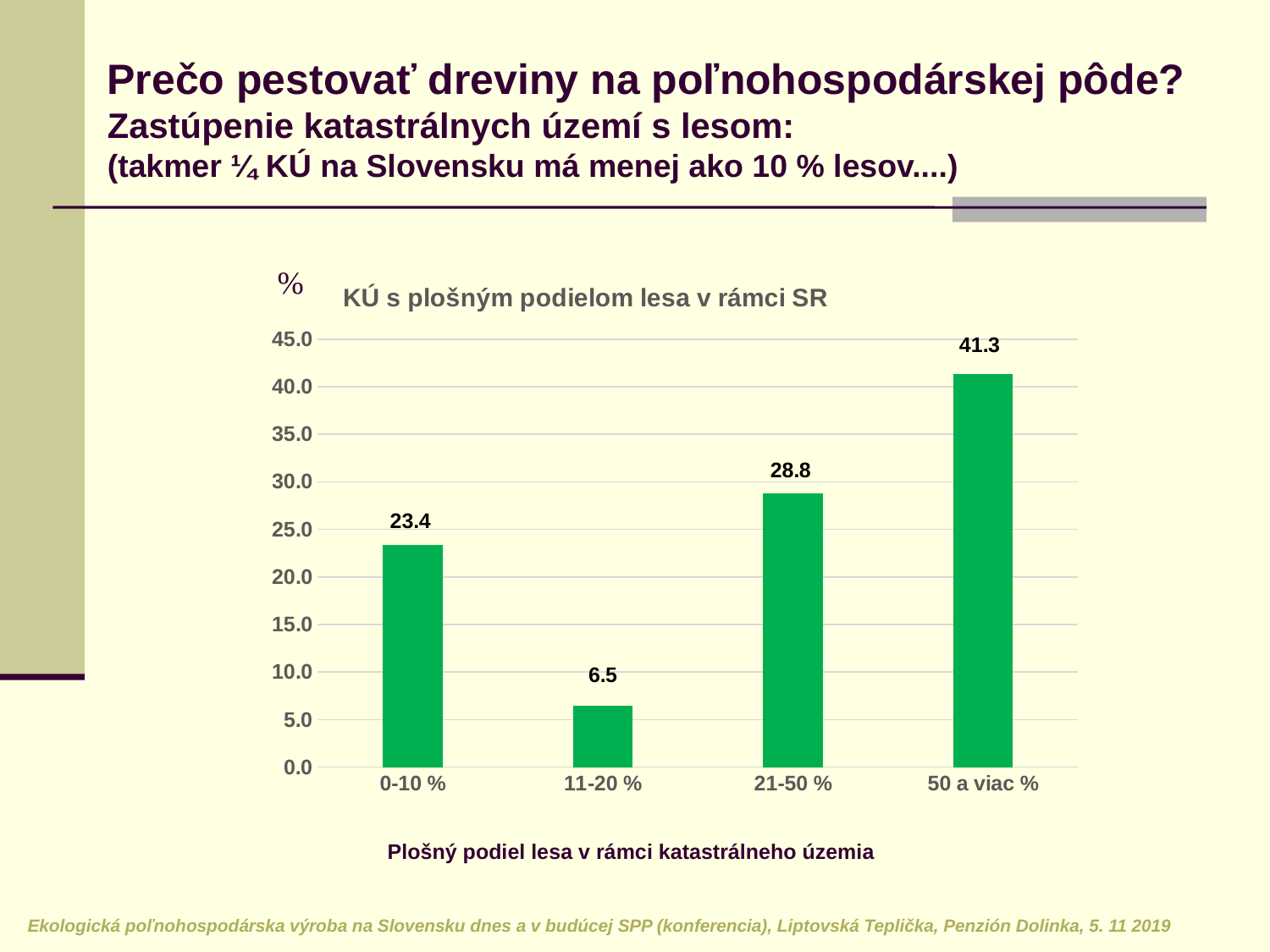
What is the value for the 11-20 % category? 6.5 What is the difference between the values for 50 a viac % and 0-10 %? 17.9 Which category has the lowest value? 11-20 % Which category has the highest value? 50 a viac % What is the title of the chart? KÚ s plošným podielom lesa v rámci SR What is the value for the 21-50 % category? 28.8 What is the value for the 0-10 % category? 23.4 Is the value for 21-50 % greater or less than 30.0? less Which is larger, the value for 21-50 % or the value for 0-10 %? 21-50 % What kind of chart is shown on the slide? bar chart What is the value for the 50 a viac % category? 41.3 How many categories are shown on the x axis? 4